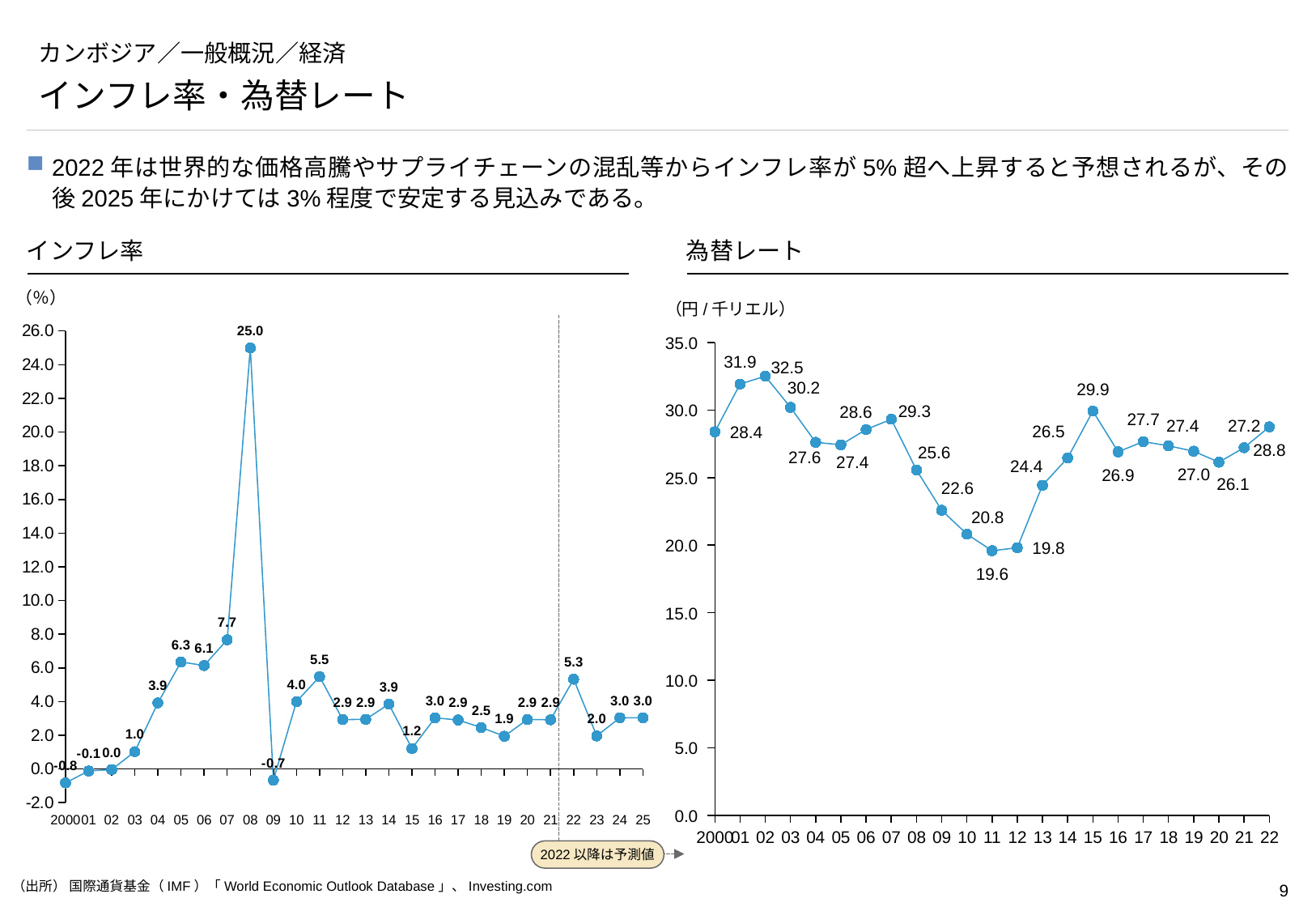
In the インフレ率 chart, what is the difference between the 2022 value (5.3) and the 2023 value (2.0)? 3.3 What type of chart is the 為替レート chart? line chart In the 為替レート chart, which year has the lowest value? 2011 In the インフレ率 chart, which year has the highest inflation rate? 2008 In the インフレ率 chart, what is the inflation rate for 2008? 25.0 In the インフレ率 chart, what is the value for 2022? 5.3 In the 為替レート chart, what is the value for 2011? 19.6 In the 為替レート chart, which year has the highest value? 2002 In the 為替レート chart, what unit is shown on the axis label? 円/千リエル In the インフレ率 chart, which year has the lowest inflation rate? 2000 In the 為替レート chart, what is the difference between the 2002 value (32.5) and the 2011 value (19.6)? 12.9 In the インフレ率 chart, is the value for 2011 larger or smaller than the value for 2010? larger